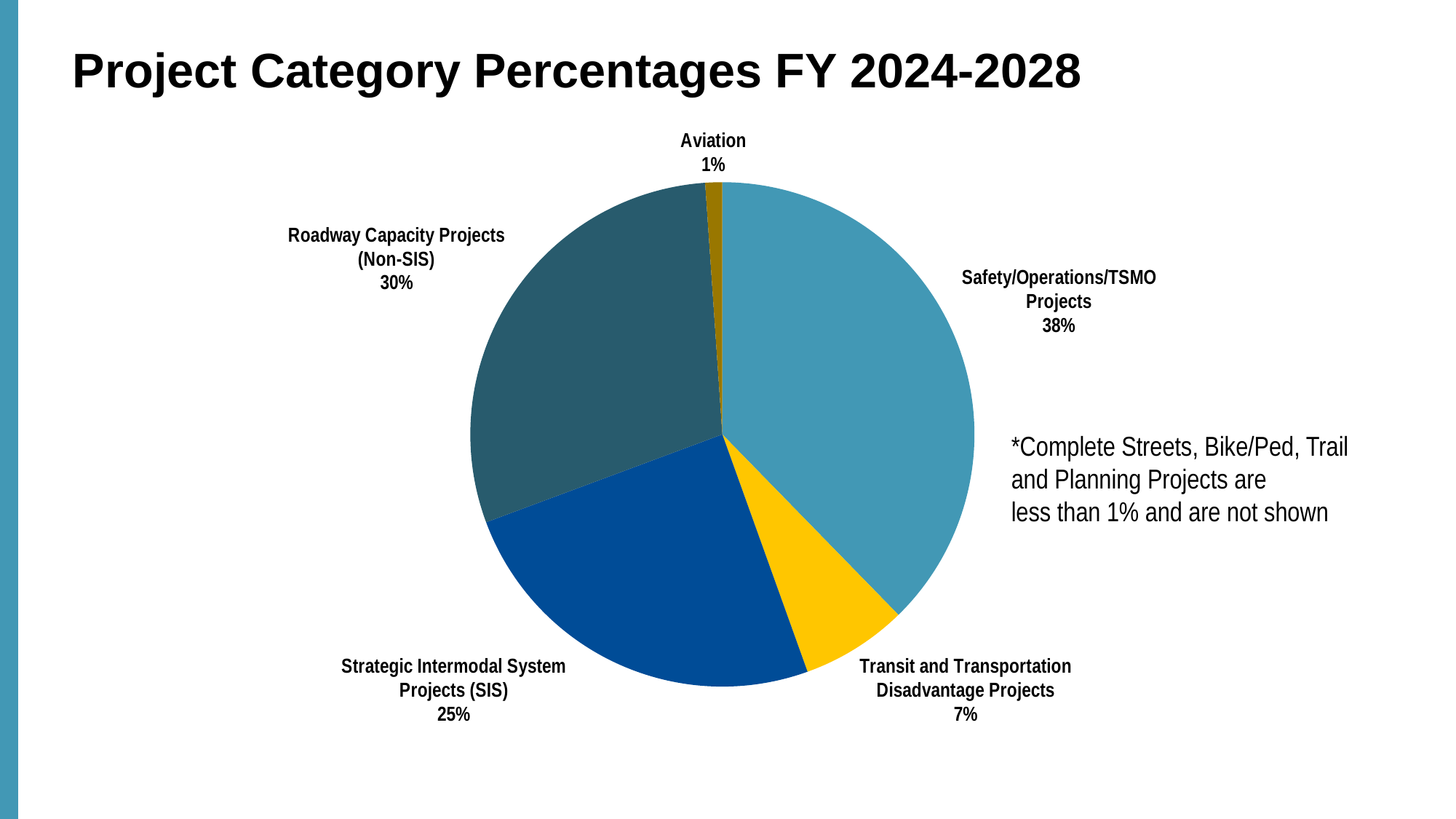
What is the title of the slide containing the pie chart? Project Category Percentages FY 2024-2028 What kind of chart is shown on the slide? Pie chart Which project category has the smallest share of the pie? Aviation Which is larger: Roadway Capacity Projects (Non-SIS) or Strategic Intermodal System Projects (SIS)? Roadway Capacity Projects (Non-SIS) How many project categories are shown as slices in the pie chart? 5 What percentage is shown for Safety/Operations/TSMO Projects? 38% What percentage is shown for Aviation? 1% What is the difference in percentage points between Safety/Operations/TSMO Projects and Strategic Intermodal System Projects (SIS)? 13 Which project category has the largest share of the pie? Safety/Operations/TSMO Projects What percentage is shown for Transit and Transportation Disadvantage Projects? 7% What percentage is shown for Roadway Capacity Projects (Non-SIS)? 30% What percentage is shown for Strategic Intermodal System Projects (SIS)? 25%